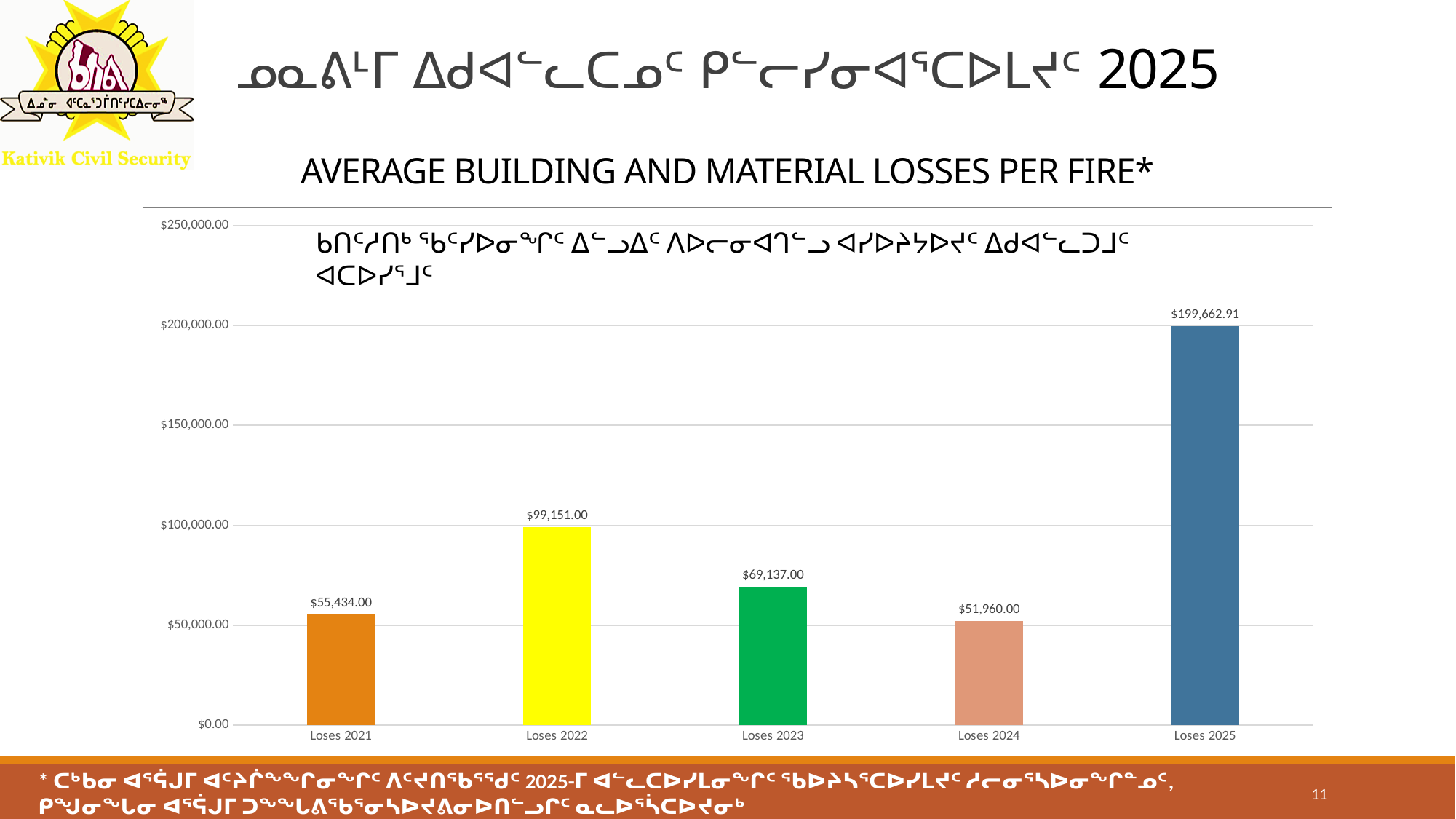
What is the value for Loses 2025? $199,662.91 Which is larger, the value for Loses 2022 or the value for Loses 2023? Loses 2022 Which category has the lowest value? Loses 2024 What is the value for Loses 2021? $55,434.00 Which category has the highest value? Loses 2025 How many categories are shown on the x axis? 5 What is the value for Loses 2023? $69,137.00 Does the value rise or fall from Loses 2023 to Loses 2024? fall What kind of chart is shown on the slide? bar chart Is the value for Loses 2024 greater or less than $100,000.00? less What is the difference between the values for Loses 2025 and Loses 2024? $147,702.91 What is the difference between the values for Loses 2022 and Loses 2021? $43,717.00